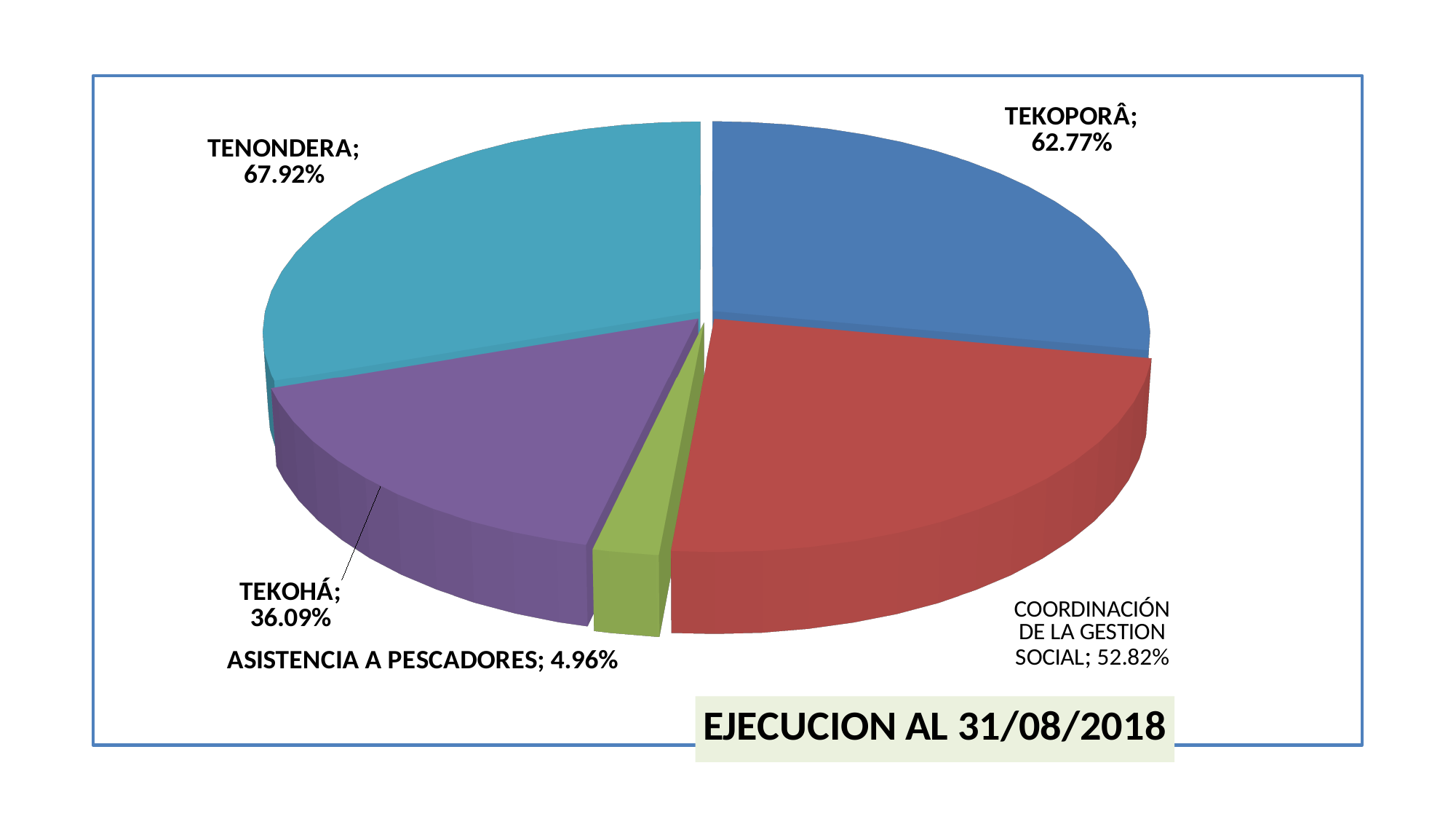
What value is shown for TEKOHÁ? 36.09% What value is shown for COORDINACIÓN DE LA GESTION SOCIAL? 52.82% What value is shown for TENONDERA? 67.92% Which category has the highest labelled value? TENONDERA What is the difference between the values for TENONDERA and TEKOPORÂ? 5.15% What value is shown for ASISTENCIA A PESCADORES? 4.96% What kind of chart is shown on the slide? Pie chart Which category has the lowest labelled value? ASISTENCIA A PESCADORES How many slices does the pie chart have? 5 Which has the larger value, TEKOPORÂ or COORDINACIÓN DE LA GESTION SOCIAL? TEKOPORÂ What value is shown for TEKOPORÂ? 62.77% What date does the text box on the slide say the execution is as of? 31/08/2018